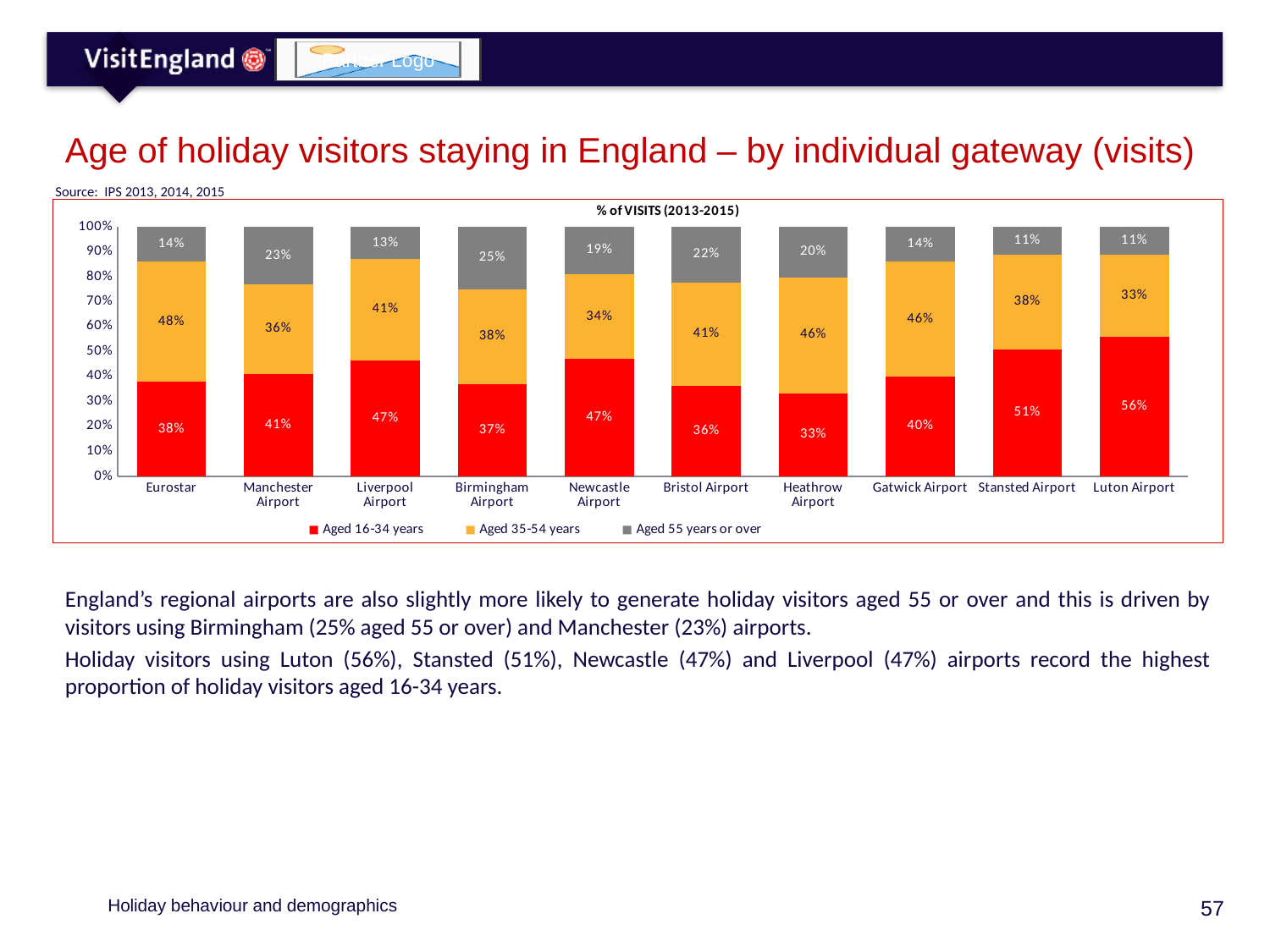
What kind of chart is shown on the slide? Stacked bar chart What percentage of holiday visitors using Luton Airport are aged 16-34 years? 56% What is the difference between the share of visitors aged 16-34 years at Luton Airport and at Heathrow Airport? 23 percentage points What percentage of holiday visitors using Eurostar are aged 35-54 years? 48% Which gateway has the lowest share of holiday visitors aged 16-34 years? Heathrow Airport How many series does the legend list? 3 Which has a larger share of visitors aged 35-54 years: Eurostar or Manchester Airport? Eurostar What is the title of the chart? % of VISITS (2013-2015) Which gateway has the highest share of holiday visitors aged 55 years or over? Birmingham Airport What percentage of holiday visitors using Birmingham Airport are aged 55 years or over? 25% Which gateway has the highest share of holiday visitors aged 16-34 years? Luton Airport How many gateways are shown on the chart? 10